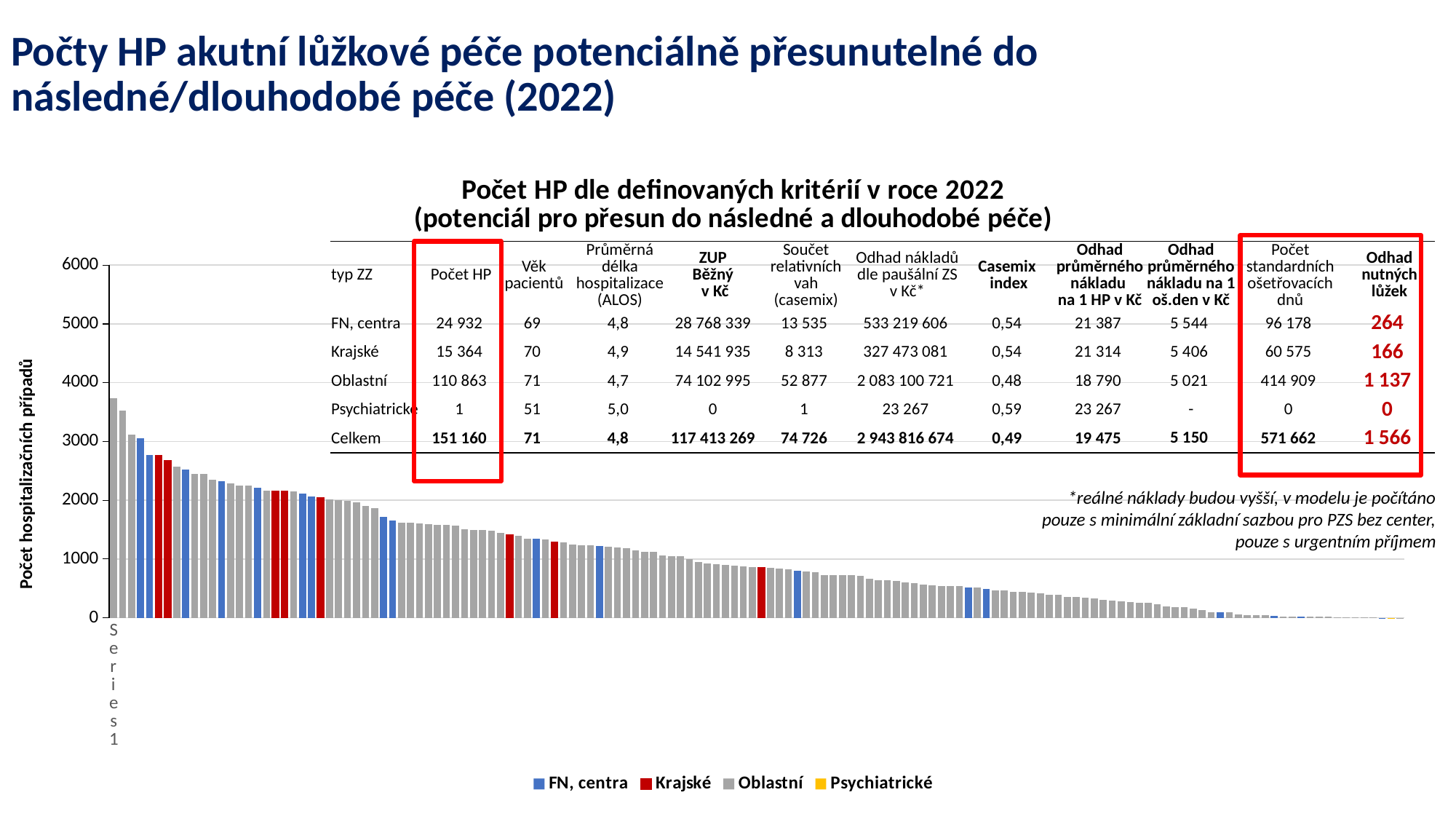
What kind of chart is shown on the slide? Bar chart Is the value of the tallest bar in the chart greater or less than 3000? greater How many series does the chart legend list? 4 Do the bar values rise or fall from left to right along the x axis? Fall What colour represents the series 'FN, centra' in the chart legend? Blue Which legend series does the tallest bar in the chart belong to? Oblastní What is the highest value shown on the vertical axis of the chart? 6000 Is the value of the tallest bar in the chart greater or less than 4000? less Is the value of the first red (Krajské) bar greater or less than 3000? less